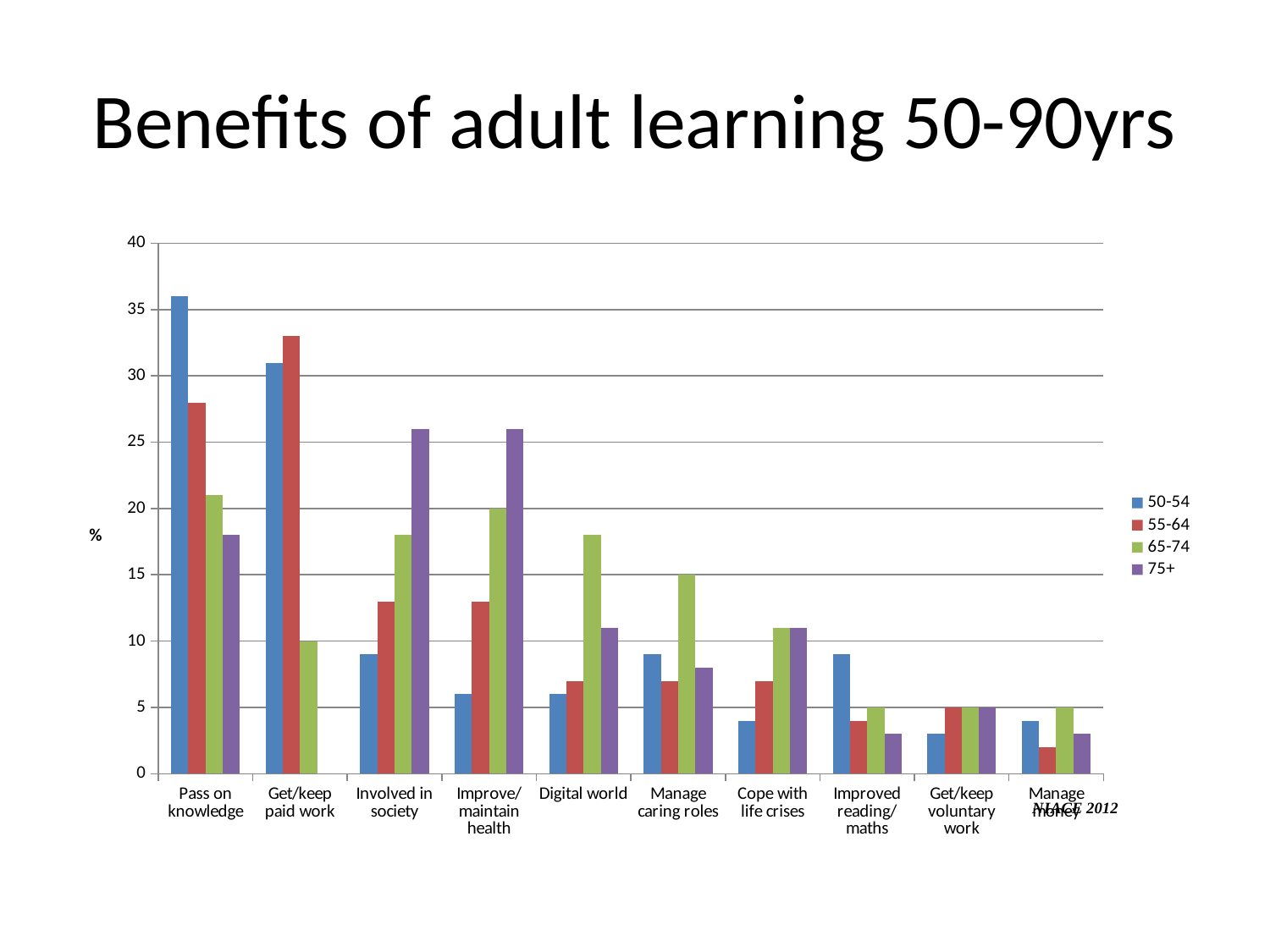
Is the value for 55-64 in 'Get/keep paid work' greater or less than 30? greater How many benefit categories are shown along the x axis? 10 How many series does the legend list? 4 Is the value for 50-54 in 'Pass on knowledge' greater or less than 35? greater Which age group has the lowest bar for 'Pass on knowledge'? 75+ Is the value for 50-54 in 'Cope with life crises' greater or less than 5? less For 'Pass on knowledge', which is larger: the 50-54 bar or the 55-64 bar? 50-54 Which age group has the tallest bar for 'Involved in society'? 75+ What kind of chart is shown on the slide? bar chart Which age group has the tallest bar for 'Digital world'? 65-74 What is the label on the vertical axis? %